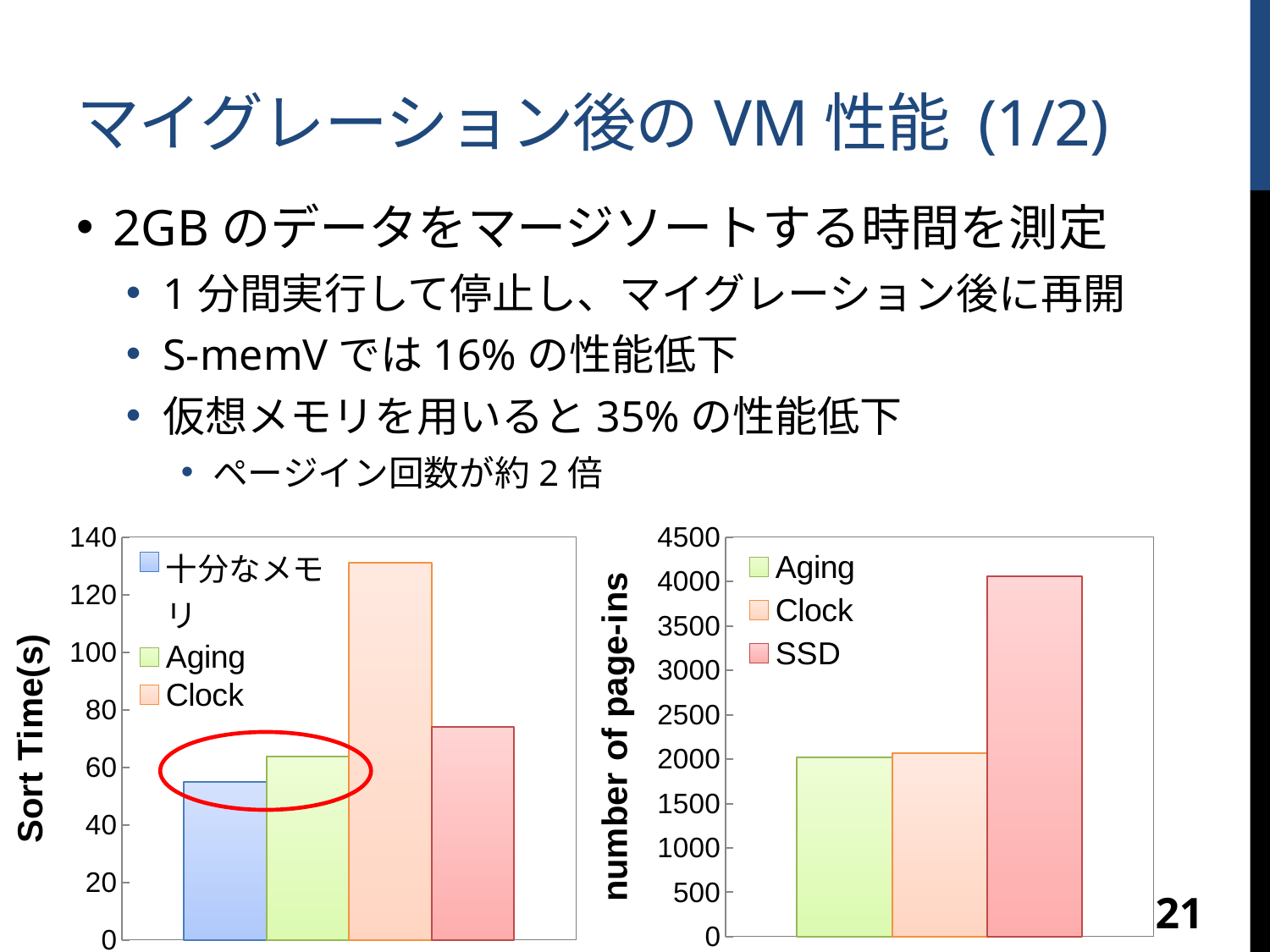
In the right chart (number of page-ins), which legend entry has the highest number of page-ins? SSD What kind of chart is the left chart (Sort Time(s))? bar chart In the left chart (Sort Time(s)), is the value for 十分なメモリ greater or less than 60? less In the left chart (Sort Time(s)), which legend entry has the highest sort time? Clock In the right chart (number of page-ins), is the value for Aging greater or less than 2500? less In the left chart (Sort Time(s)), which legend entry has the lowest sort time? 十分なメモリ What is the y-axis title of the right chart? number of page-ins In the left chart (Sort Time(s)), is the value for Clock greater or less than 120? greater How many entries does the legend of the left chart (Sort Time(s)) list? 3 In the left chart (Sort Time(s)), which is larger, the sort time for Clock or for Aging? Clock